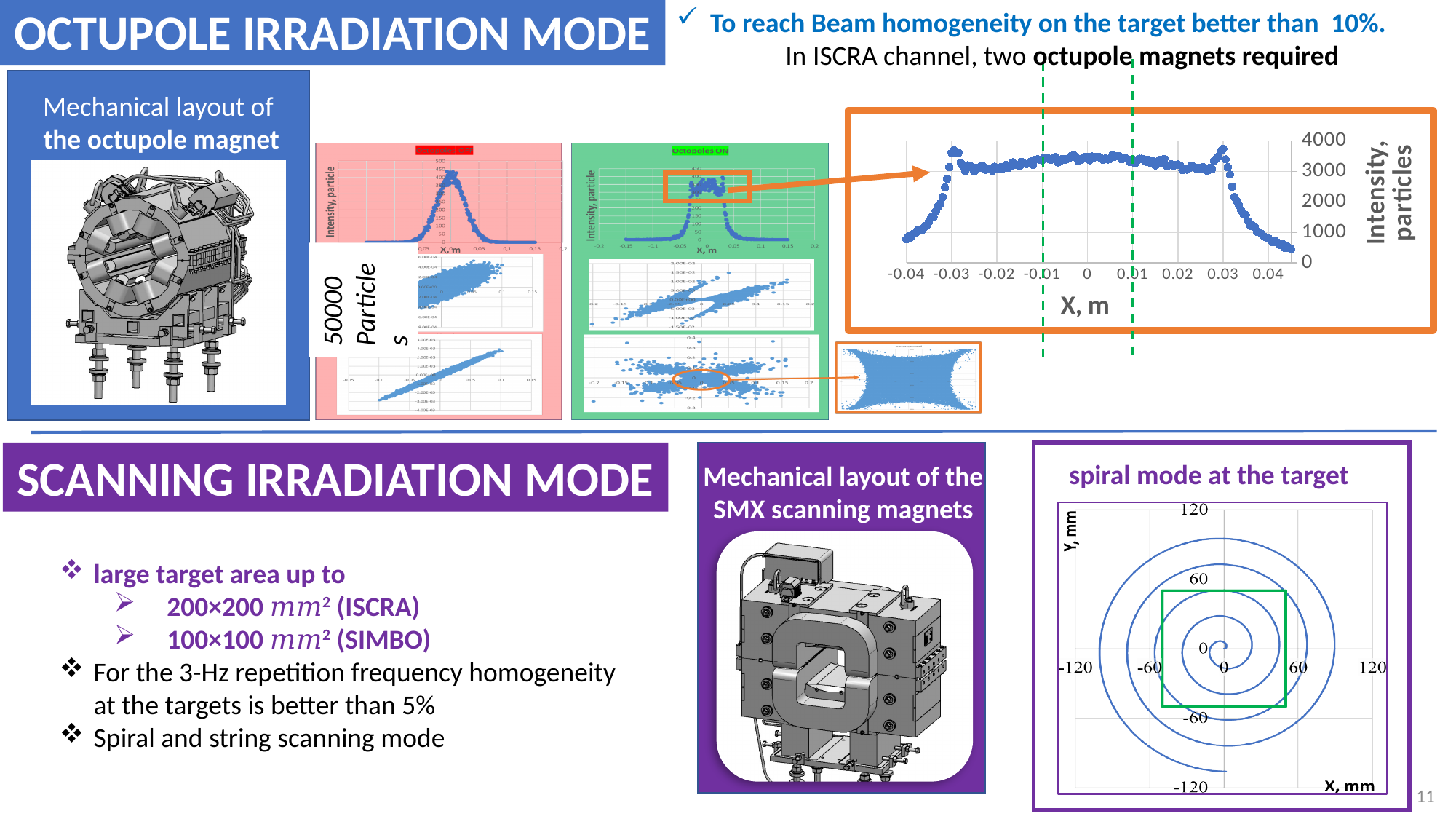
In the large orange-bordered chart at the top right, what is the highest tick value shown on the vertical axis? 4000 In the large orange-bordered chart at the top right, do the intensity values rise or fall as X goes from -0.04 to -0.03? rise In the large orange-bordered chart at the top right, which is larger: the intensity at X = 0 or the intensity at X = 0.04? X = 0 In the large orange-bordered chart at the top right, what is the label of the horizontal axis? X, m In the large orange-bordered chart at the top right, is the intensity at X = 0.04 greater or less than 1000? less In the large orange-bordered chart at the top right, is the intensity at X = 0 greater or less than 2000? greater In the spiral mode chart at the bottom right, what is the largest tick value shown on the X, mm axis? 120 In the spiral mode chart at the bottom right, what is the lowest tick value shown on the Y, mm axis? -120 In the large orange-bordered chart at the top right, is the intensity at X = -0.04 greater or less than 1000? less What is the title of the chart in the bottom right corner of the slide? spiral mode at the target In the large orange-bordered chart at the top right, what is the label of the vertical axis? Intensity, particles In the large orange-bordered chart at the top right, do the intensity values rise or fall as X goes from 0.03 to 0.04? fall